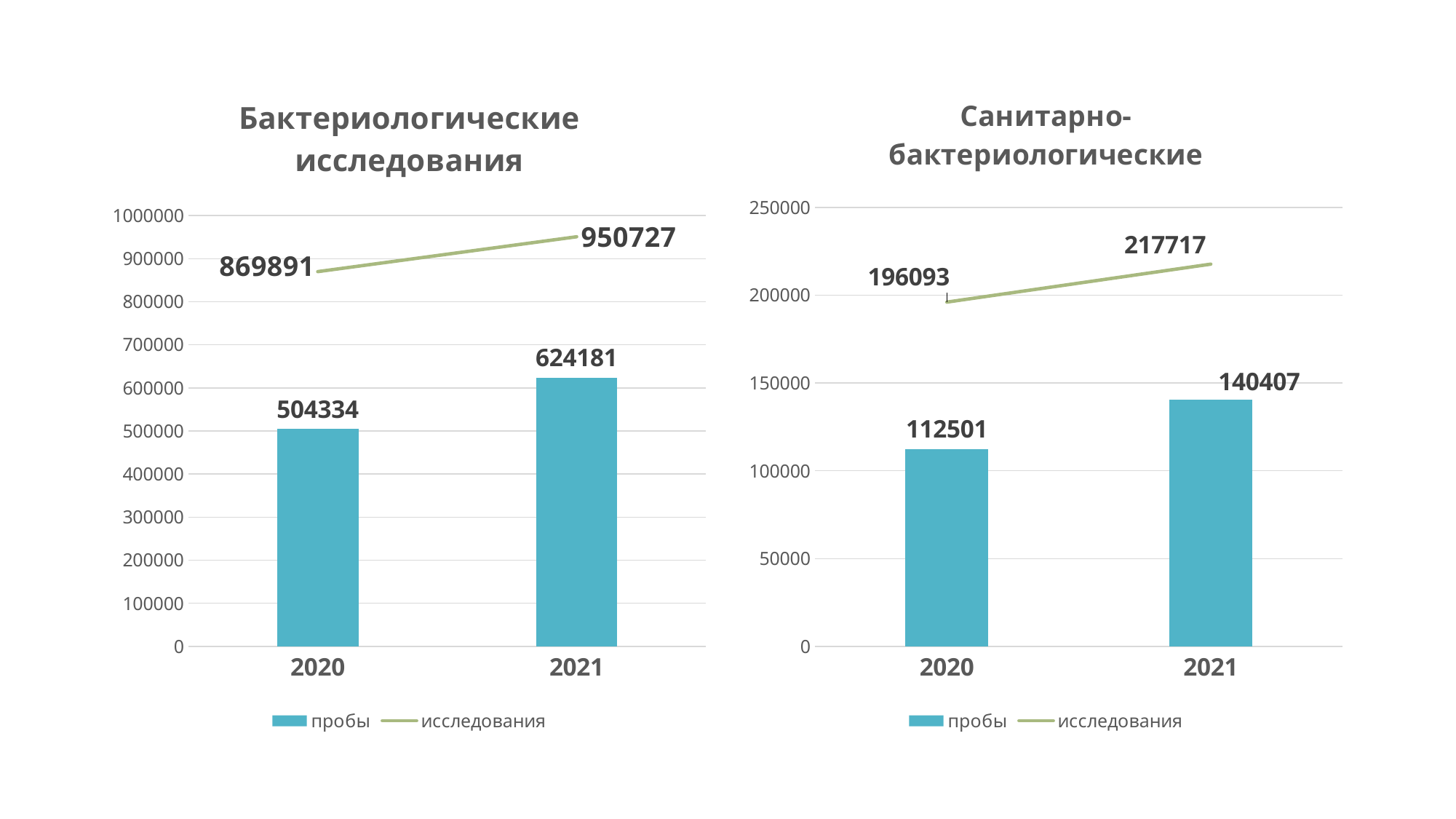
How many series does the legend of the 'Санитарно-бактериологические' chart list? 2 In the 'Санитарно-бактериологические' chart, which year has the lower value of пробы? 2020 In the 'Бактериологические исследования' chart, what is the value of исследования for 2020? 869891 In the 'Санитарно-бактериологические' chart, what is the value of исследования for 2021? 217717 In the 'Бактериологические исследования' chart, what is the value of пробы for 2021? 624181 In the 'Бактериологические исследования' chart, does the исследования line rise or fall from 2020 to 2021? rise In the 'Санитарно-бактериологические' chart, what is the value of пробы for 2020? 112501 In the 'Санитарно-бактериологические' chart, is the value of пробы for 2021 greater or less than 150000? less In the 'Бактериологические исследования' chart, which year has the higher value of исследования? 2021 In the 'Санитарно-бактериологические' chart, what is the difference between исследования in 2021 and 2020? 21624 What kind of chart is the 'Бактериологические исследования' chart? Combined bar and line chart In the 'Бактериологические исследования' chart, by how much did пробы increase from 2020 to 2021? 119847